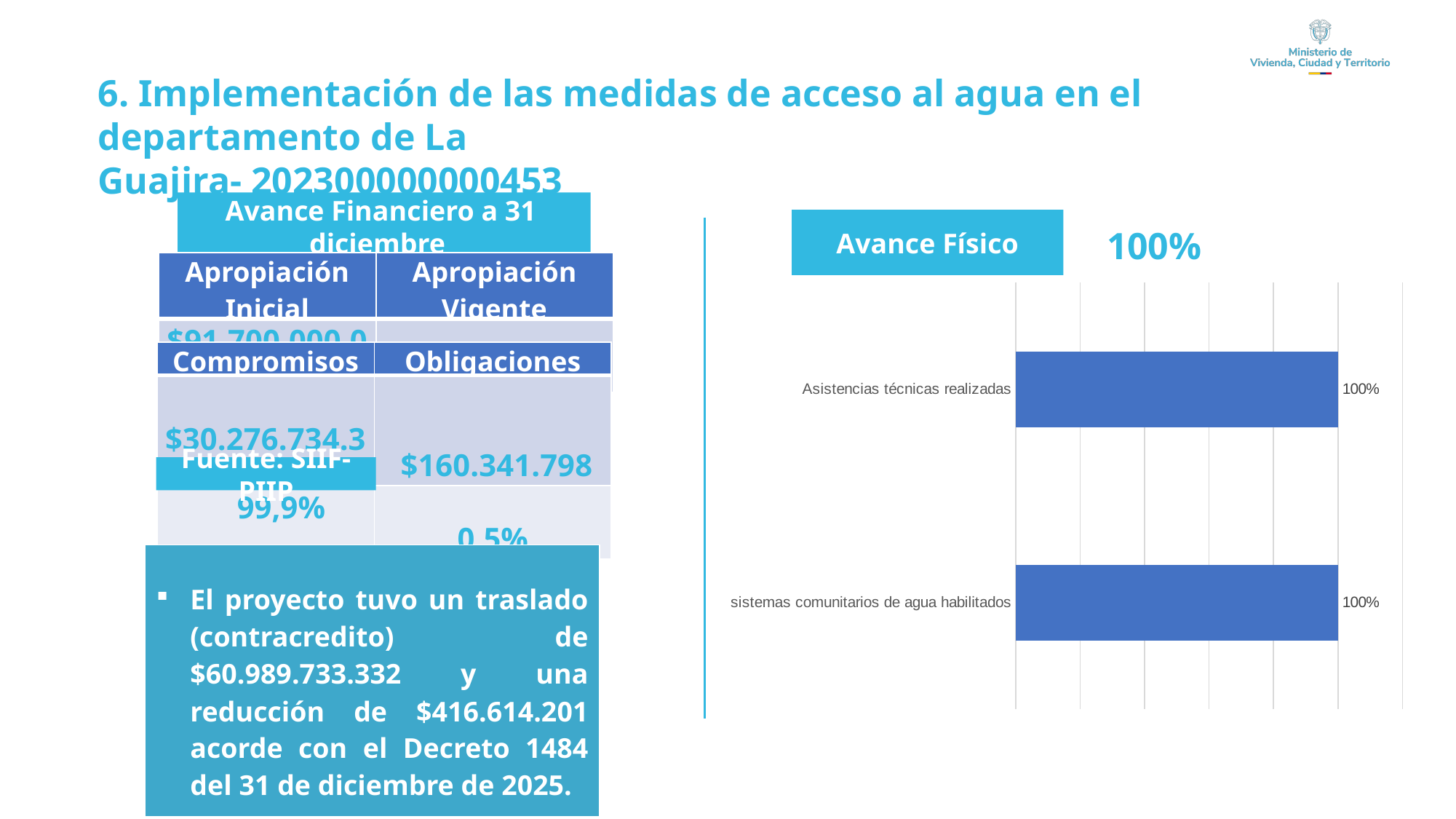
What is the value for sistemas comunitarios de agua habilitados in the Avance Físico chart? 100% Are the bars in the Avance Físico chart horizontal or vertical? Horizontal How many categories are plotted in the Avance Físico chart? 2 Do the two categories in the Avance Físico chart have the same value? Yes What is the value for Asistencias técnicas realizadas in the Avance Físico chart? 100% What kind of chart is the Avance Físico chart? Bar chart What colour are the bars in the Avance Físico chart? Blue